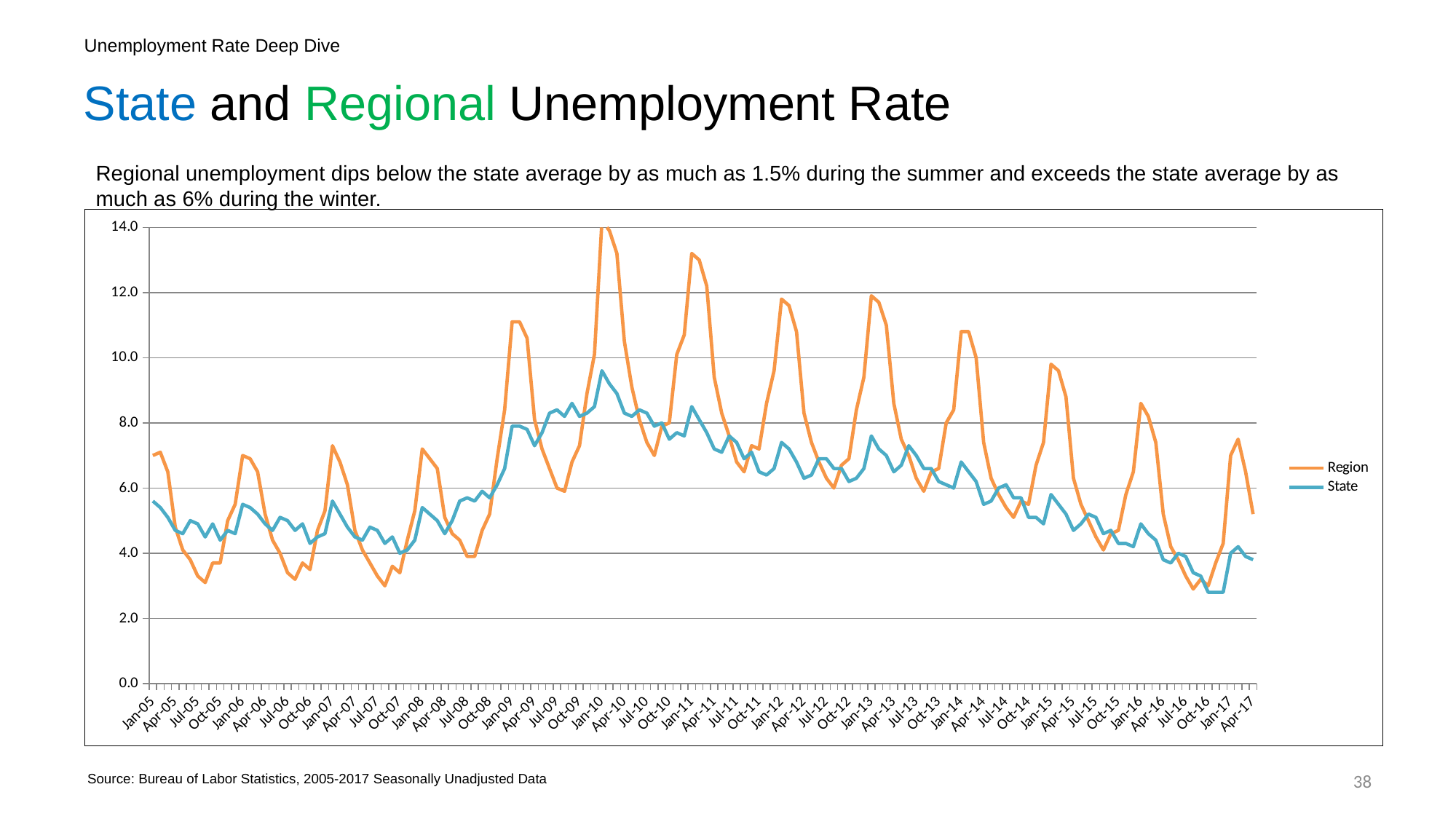
Does the State line generally rise or fall from Jan-10 to Apr-17? fall Around Jul-05, which series has the larger value, Region or State? State What colour is the Region line? orange Around Jan-13, which series has the larger value, Region or State? Region Is the Region value around Oct-16 greater or less than 4.0? less Which series reaches the highest value on the chart? Region Is the Region value around Jan-15 greater or less than 8.0? greater Is the State value around Jan-10 greater or less than 10.0? less What kind of chart is shown on the slide? line chart How many series does the legend list? 2 What are the two series named in the legend? Region and State